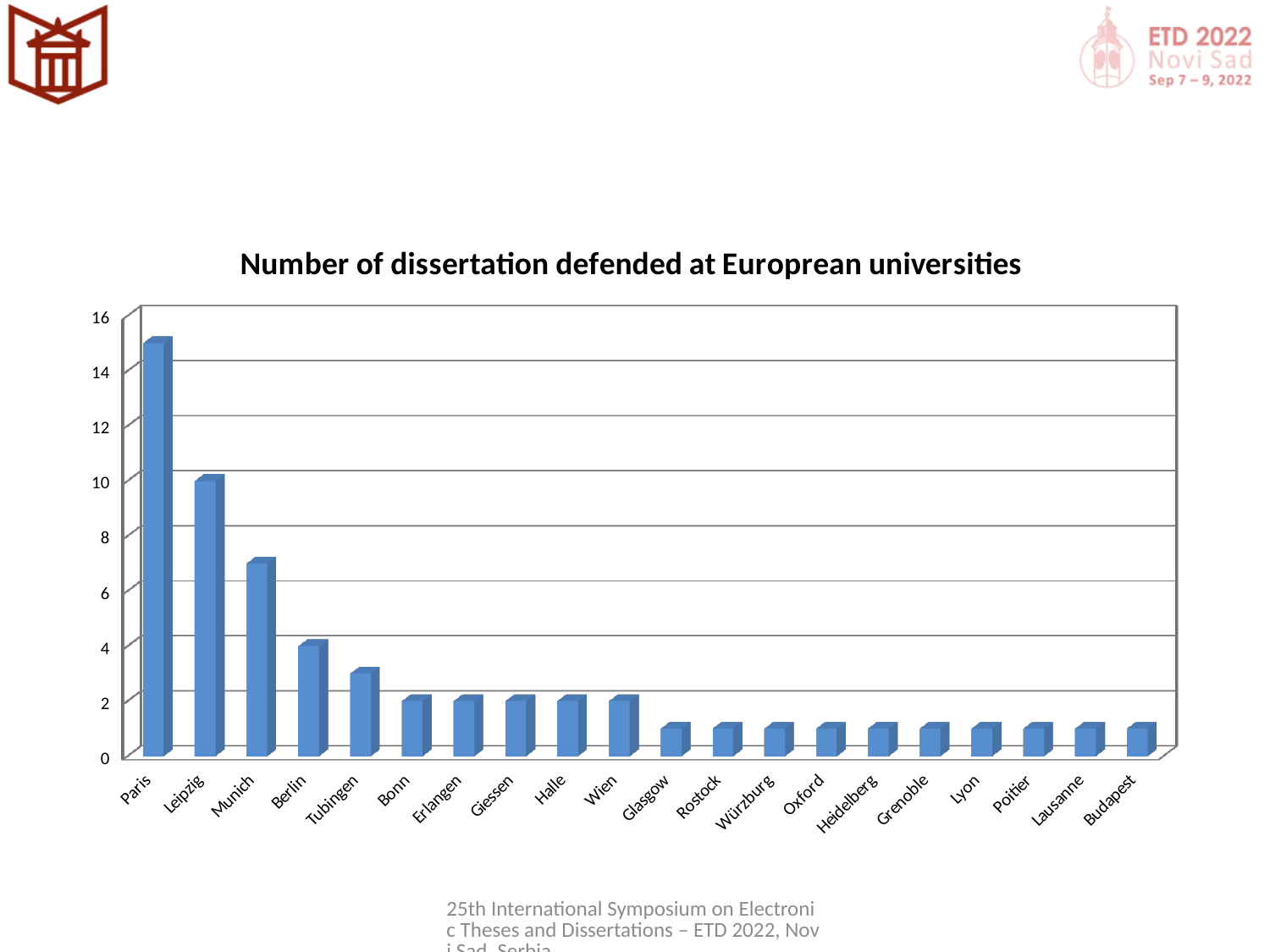
Is the value for Glasgow greater or less than 2? less What is the value for Berlin? 4 Is the value for Paris greater or less than 14? greater Which has a larger value, Leipzig or Munich? Leipzig What is the title of the chart? Number of dissertation defended at Europrean universities Is the value for Munich greater or less than 6? greater Do the values generally rise or fall moving from left to right along the x axis? fall How many universities are shown on the x axis of the chart? 20 What is the value for Leipzig? 10 Which university has the highest number of dissertations defended? Paris What is the value for Bonn? 2 What kind of chart is shown on the slide? bar chart